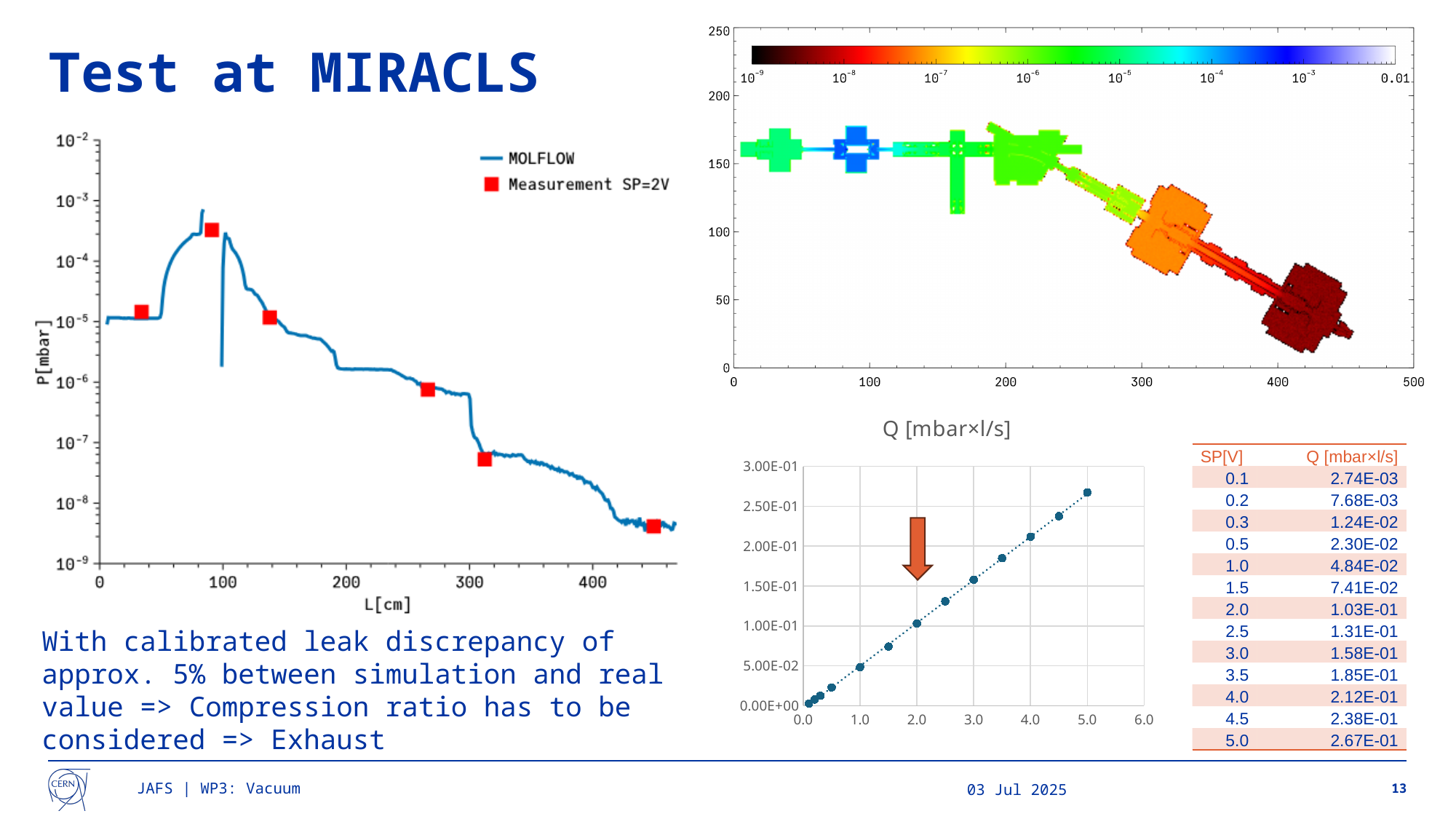
On the bottom-right chart Q [mbar×l/s], what is the value of Q at SP = 2.0 V? 1.03E-01 On the bottom-right chart Q [mbar×l/s], which is larger: Q at SP = 3.0 or Q at SP = 2.5? SP = 3.0 On the left chart (P[mbar] vs L[cm]), does the pressure generally rise or fall along L beyond 100 cm? fall On the bottom-right chart Q [mbar×l/s], which SP value has the highest Q? 5.0 On the left chart (P[mbar] vs L[cm]), what are the two legend entries? MOLFLOW and Measurement SP=2V On the left chart (P[mbar] vs L[cm]), how many series does the legend list? 2 On the left chart (P[mbar] vs L[cm]), is the measurement point near L = 450 cm greater or less than 10^-8 mbar? less On the left chart (P[mbar] vs L[cm]), is the measurement point near L = 90 cm greater or less than 10^-4 mbar? greater On the left chart (P[mbar] vs L[cm]), how many red measurement points are plotted? 6 On the bottom-right chart Q [mbar×l/s], do the values rise or fall as SP increases? rise On the bottom-right chart Q [mbar×l/s], how many data points are plotted? 13 What is the title of the bottom-right scatter chart? Q [mbar×l/s]